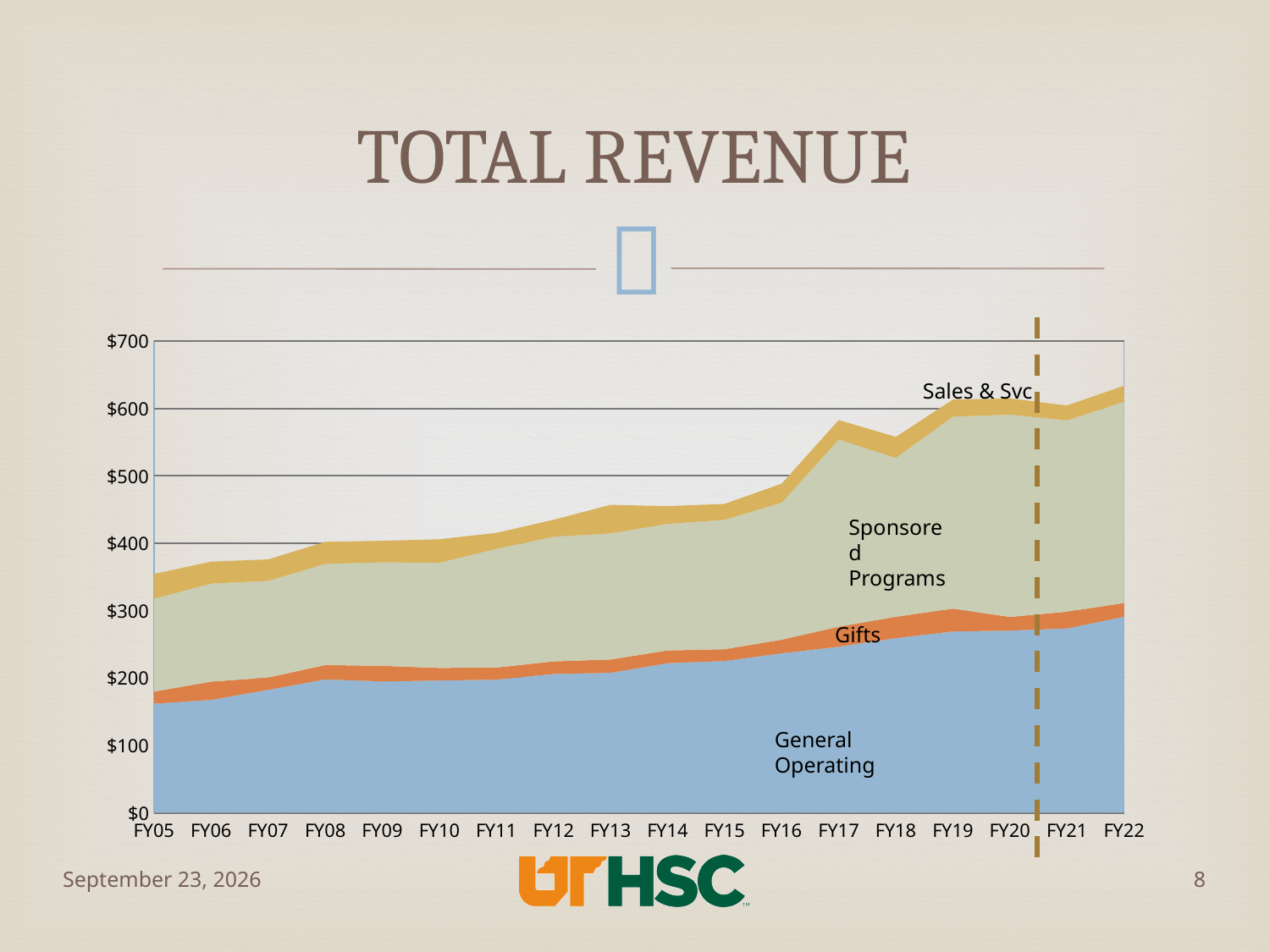
How many fiscal years are shown along the x axis? 18 Does total revenue generally rise or fall from FY05 to FY22? rise What kind of chart is shown on the slide? Stacked area chart Is the total revenue in FY05 greater or less than $400? less Is the total revenue in FY22 greater or less than $600? greater How many revenue series are labelled in the chart? 4 What is the title of the chart? TOTAL REVENUE Is the General Operating value in FY05 greater or less than $200? less Which revenue series forms the bottom layer of the stacked area? General Operating Which fiscal year has the highest total revenue? FY22